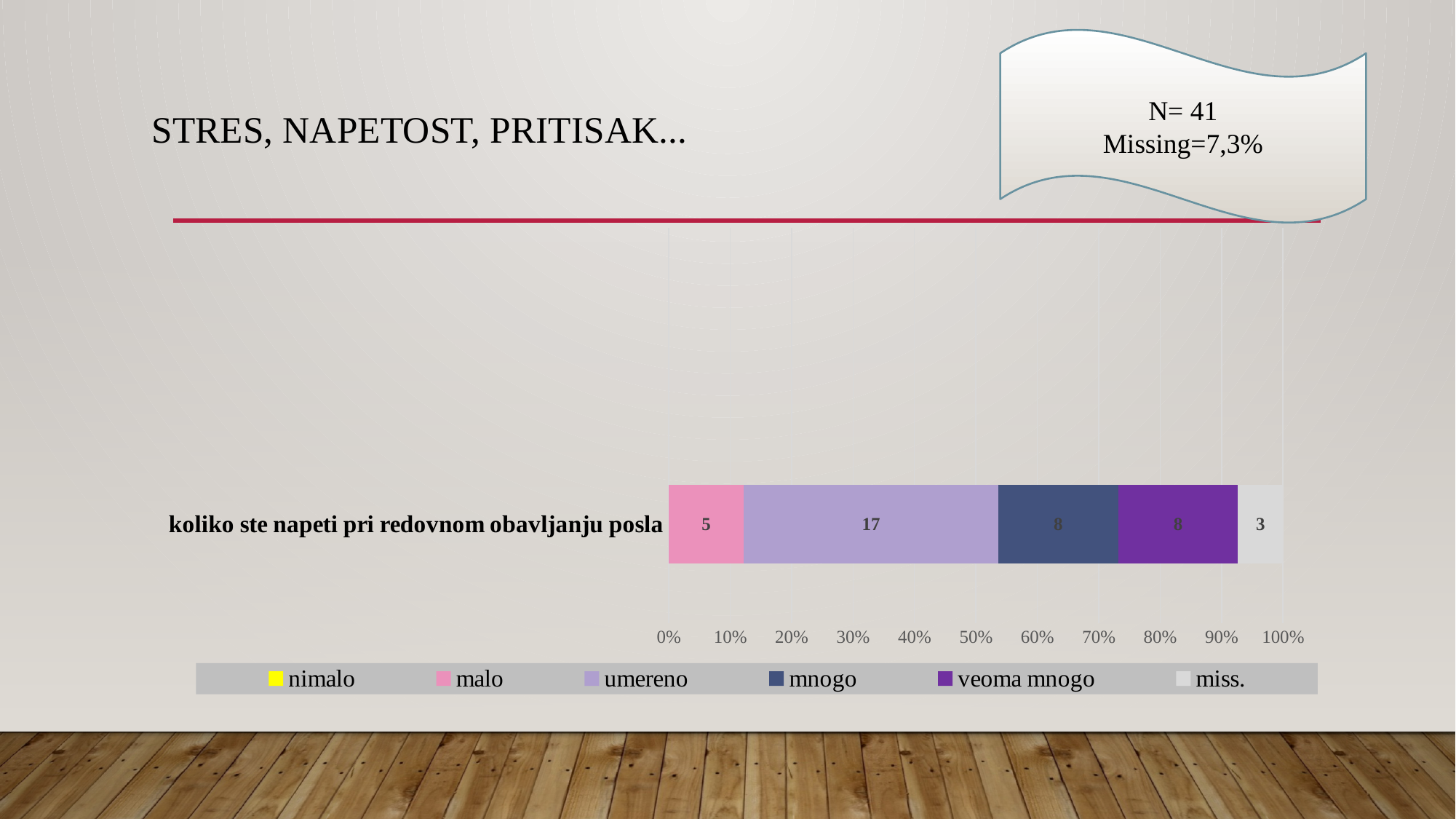
What is the value for "mnogo" in the bar for "koliko ste napeti pri redovnom obavljanju posla"? 8 Which series has the largest segment in the bar for "koliko ste napeti pri redovnom obavljanju posla"? umereno What is the total of all labelled segments in the bar for "koliko ste napeti pri redovnom obavljanju posla"? 41 What is the value for "malo" in the bar for "koliko ste napeti pri redovnom obavljanju posla"? 5 What is the difference between the "umereno" and "malo" values in the bar? 12 How many series does the legend list? 6 What is the value for "miss." in the bar for "koliko ste napeti pri redovnom obavljanju posla"? 3 Which is larger in the bar: the value for "malo" or the value for "mnogo"? mnogo What is the value for "umereno" in the bar for "koliko ste napeti pri redovnom obavljanju posla"? 17 Which labelled segment is the smallest in the bar for "koliko ste napeti pri redovnom obavljanju posla"? miss. What kind of chart is shown on the slide? Stacked bar chart Which legend entry is shown in yellow? nimalo